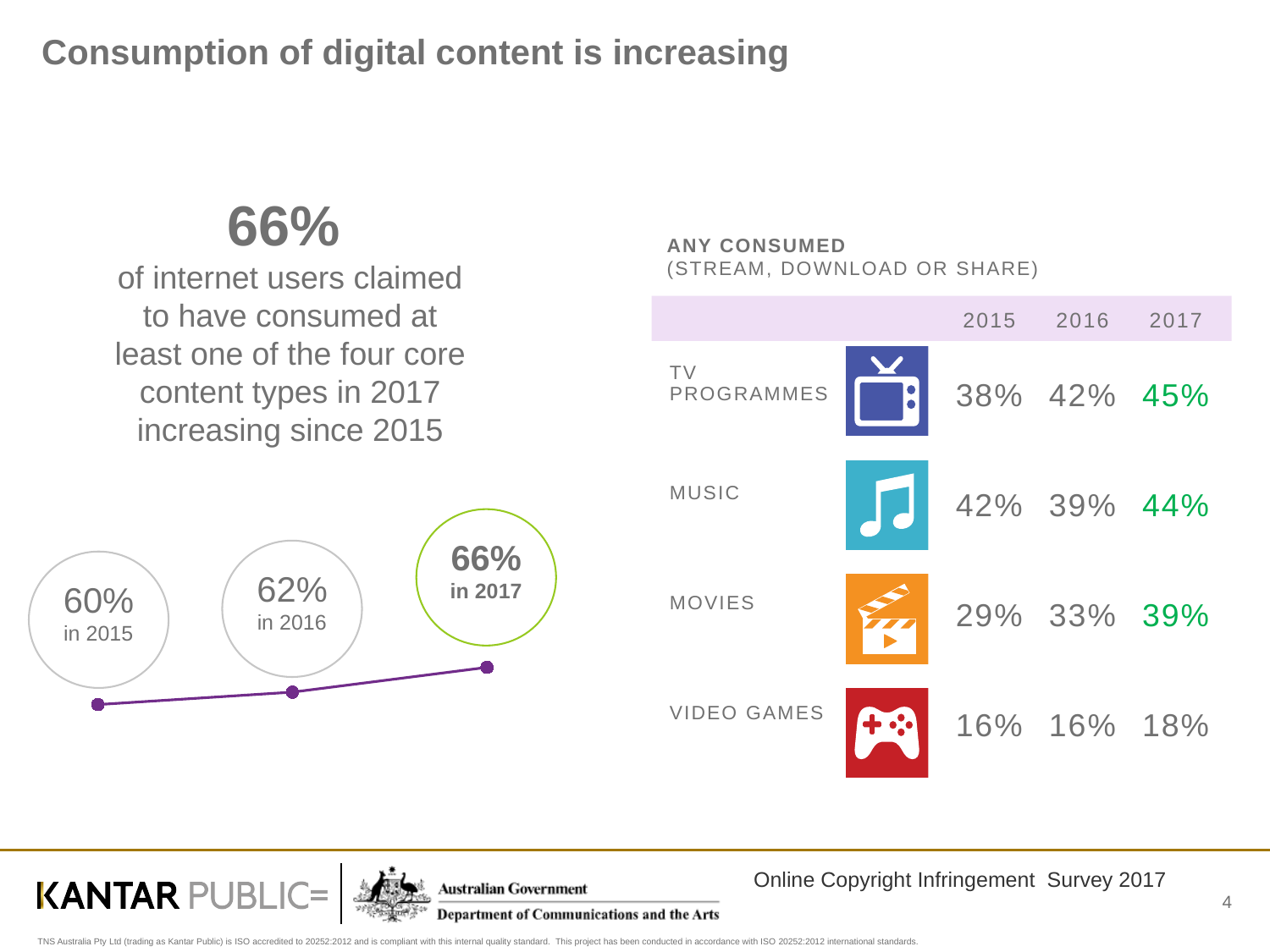
In the line chart on the left, how many data points are plotted? 3 In the line chart on the left, what is the difference between the 2017 and 2015 values? 6% In the line chart on the left, what is the value for 2017? 66% In the line chart on the left, what is the value for 2015? 60% In the line chart on the left, which year has the highest value? 2017 In the line chart on the left, what is the value for 2016? 62% In the table on the right, what is the 2017 value for Movies? 39% In the line chart on the left, do the values rise or fall from 2015 to 2017? rise What kind of chart is shown on the left of the slide? line chart In the table on the right, is the 2016 value for Music larger or smaller than the 2016 value for TV programmes? smaller In the table on the right, which content type has the lowest 2017 value? Video games In the line chart on the left, which year has the lowest value? 2015